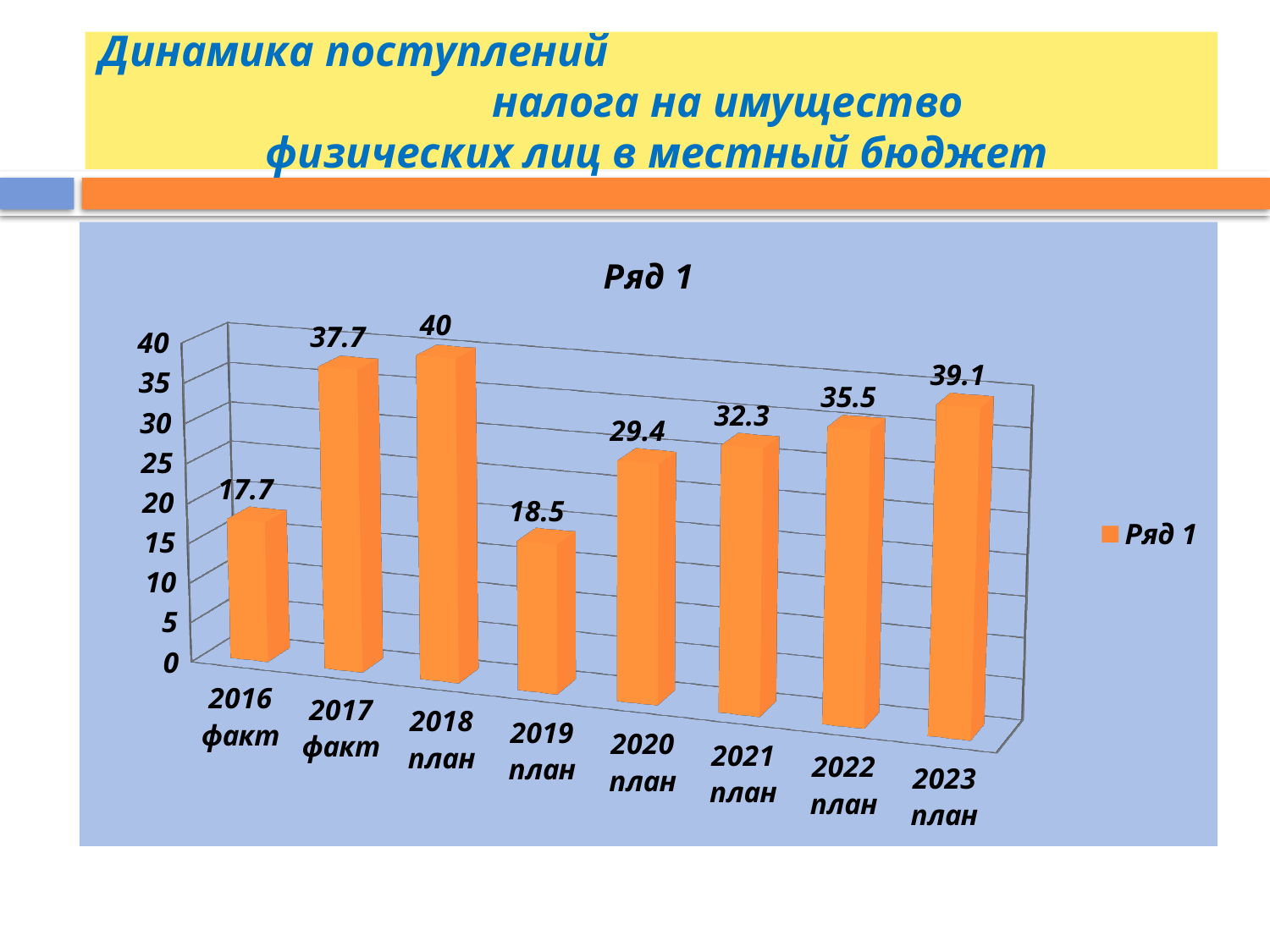
What is the value for 2016 факт? 17.7 What is the difference between the values for 2023 план and 2019 план? 20.6 What is the value for 2022 план? 35.5 Do the values rise or fall from 2019 план to 2023 план? rise How many categories are shown on the x axis? 8 Which is larger, the value for 2020 план or the value for 2021 план? 2021 план What is the value for 2019 план? 18.5 Which category has the highest value? 2018 план What is the difference between the values for 2018 план and 2017 факт? 2.3 What kind of chart is shown? bar chart How many series does the legend list? 1 Which category has the lowest value? 2016 факт